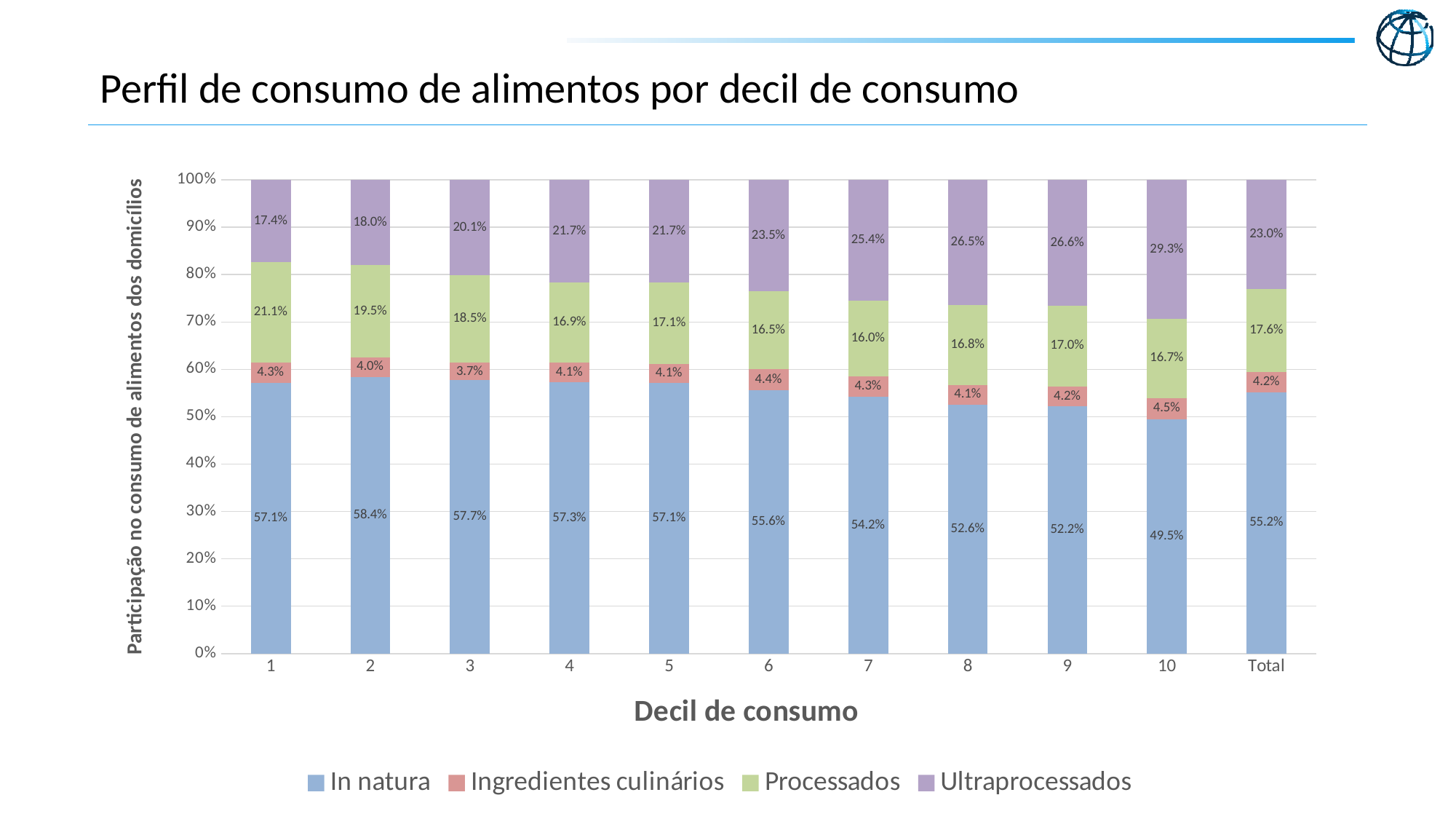
Does the Ultraprocessados share rise or fall from decil 1 to decil 10? Rise What is the Ingredientes culinários share for decil 3? 3.7% How many bars (categories) are shown on the x axis? 11 How many series does the legend list? 4 Which is larger: the Processados share in decil 1 or in decil 10? Decil 1 Which decil has the lowest In natura share? 10 What is the difference between the Ultraprocessados share in decil 10 and in decil 1? 11.9 percentage points Which decil has the highest Processados share? 1 What is the In natura share for decil 10? 49.5% What is the Ultraprocessados share for the Total bar? 23.0% Which decil has the highest Ultraprocessados share? 10 What kind of chart is shown on the slide? Stacked bar chart